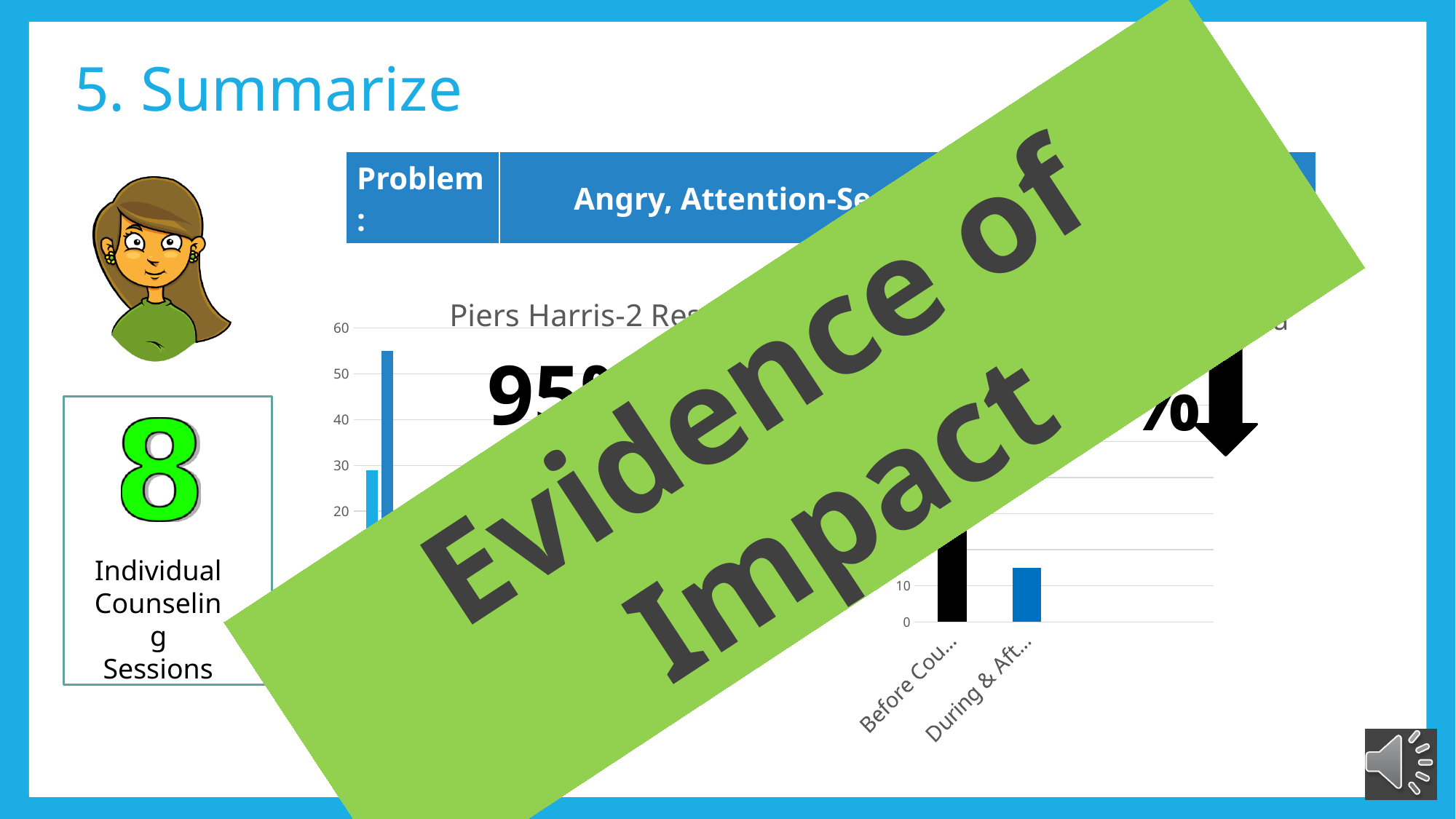
In the chart on the right of the slide, how many categories are shown on the x axis? 2 In the chart on the right of the slide, do the values fall or rise from 'Before Cou...' to 'During & Aft...'? fall What kind of chart is the chart on the right of the slide, with categories 'Before Cou...' and 'During & Aft...'? bar chart In the chart on the right of the slide, which bar is taller, 'Before Cou...' or 'During & Aft...'? Before Cou... In the chart on the right of the slide, what colour is the bar for 'During & Aft...'? blue What kind of chart is the chart on the left of the slide, titled 'Piers Harris-2 Res...'? bar chart In the chart on the left of the slide, is the shorter (first) bar greater or less than 40? less In the chart on the left of the slide, is the taller (second) bar greater or less than 50? greater In the chart on the right of the slide, what colour is the bar for 'Before Cou...'? black In the chart on the right of the slide, is the value for 'During & Aft...' greater or less than 10? greater In the chart on the left of the slide, do the values rise or fall from the first bar to the second bar? rise